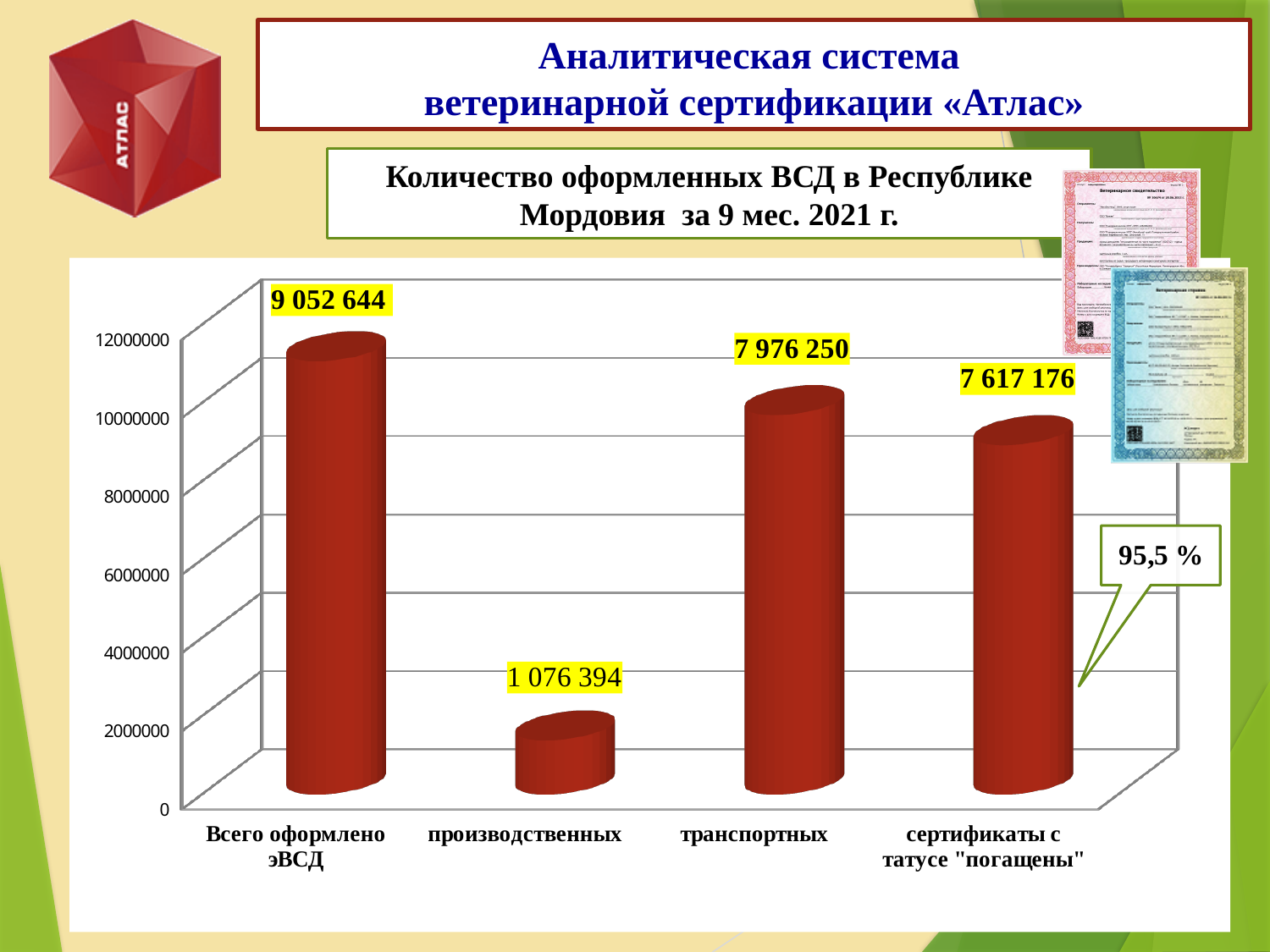
What is the value for "транспортных"? 7 976 250 What percentage is shown in the callout next to the "сертификаты с статусе "погашены"" bar? 95,5 % Which is larger, the value for "транспортных" or the value for "сертификаты с статусе "погашены""? транспортных What is the value for "производственных"? 1 076 394 What type of chart is shown on the slide? Bar chart Which category has the highest value? Всего оформлено эВСД Which category has the lowest value? производственных What is the difference between the values for "Всего оформлено эВСД" and "производственных"? 7 976 250 What is the value for "сертификаты с статусе "погашены""? 7 617 176 What is the difference between the values for "транспортных" and "сертификаты с статусе "погашены""? 359 074 How many categories are shown on the chart? 4 What is the value for "Всего оформлено эВСД"? 9 052 644